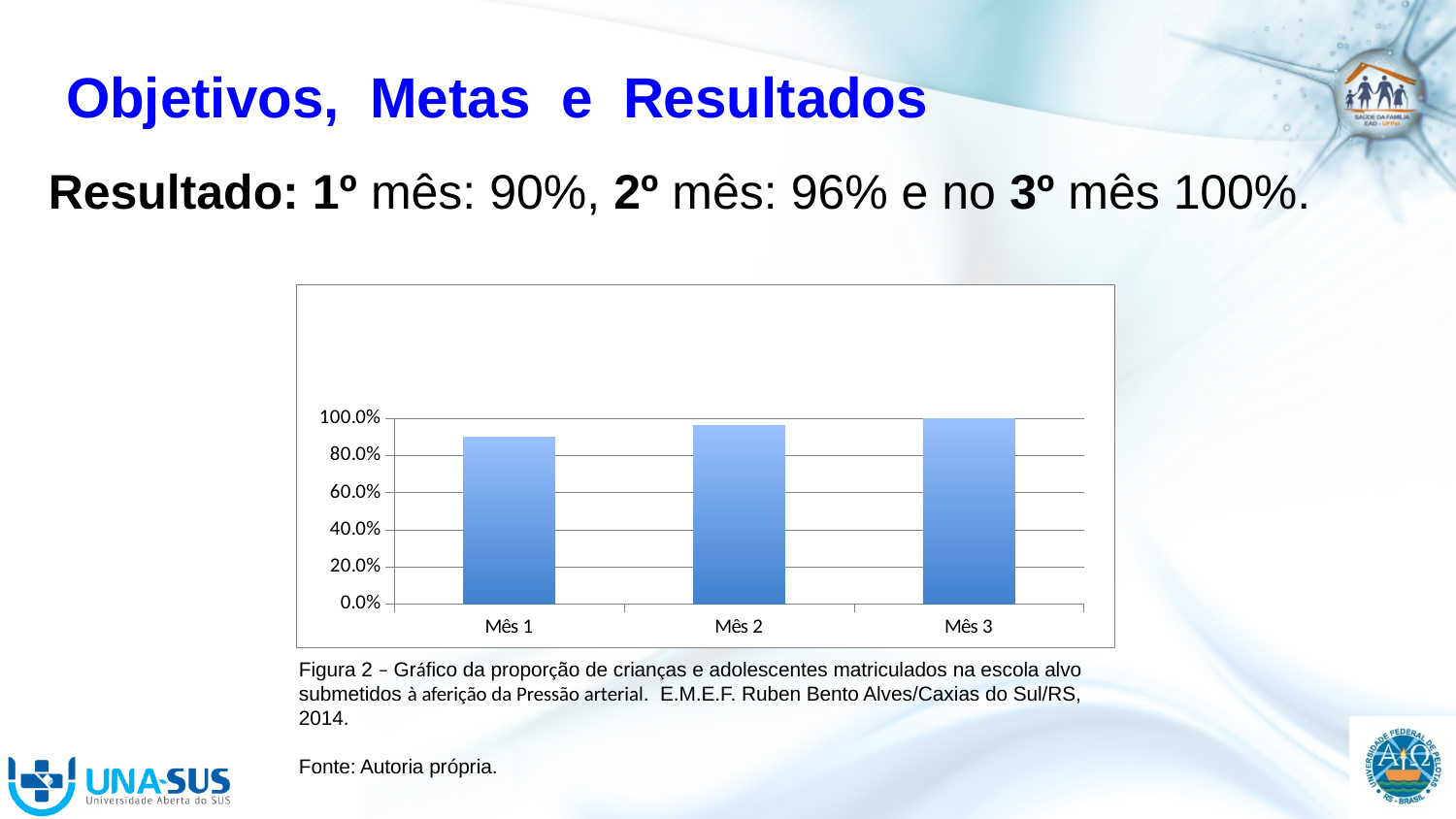
What is the highest tick label shown on the y axis of the chart? 100.0% Which month has the highest bar in the chart? Mês 3 Is the value for Mês 1 greater or less than 100.0%? less Is the value for Mês 2 greater or less than 80.0%? greater Is the value for Mês 1 greater or less than 80.0%? greater What kind of chart is shown on the slide? bar chart What are the category labels on the x axis of the chart? Mês 1, Mês 2, Mês 3 Do the values rise or fall from Mês 1 to Mês 3? rise What is the value for Mês 3 in the chart? 100.0% Which month has the lowest bar in the chart? Mês 1 Which is larger, the value for Mês 1 or the value for Mês 2? Mês 2 How many categories (months) are plotted on the x axis of the chart? 3